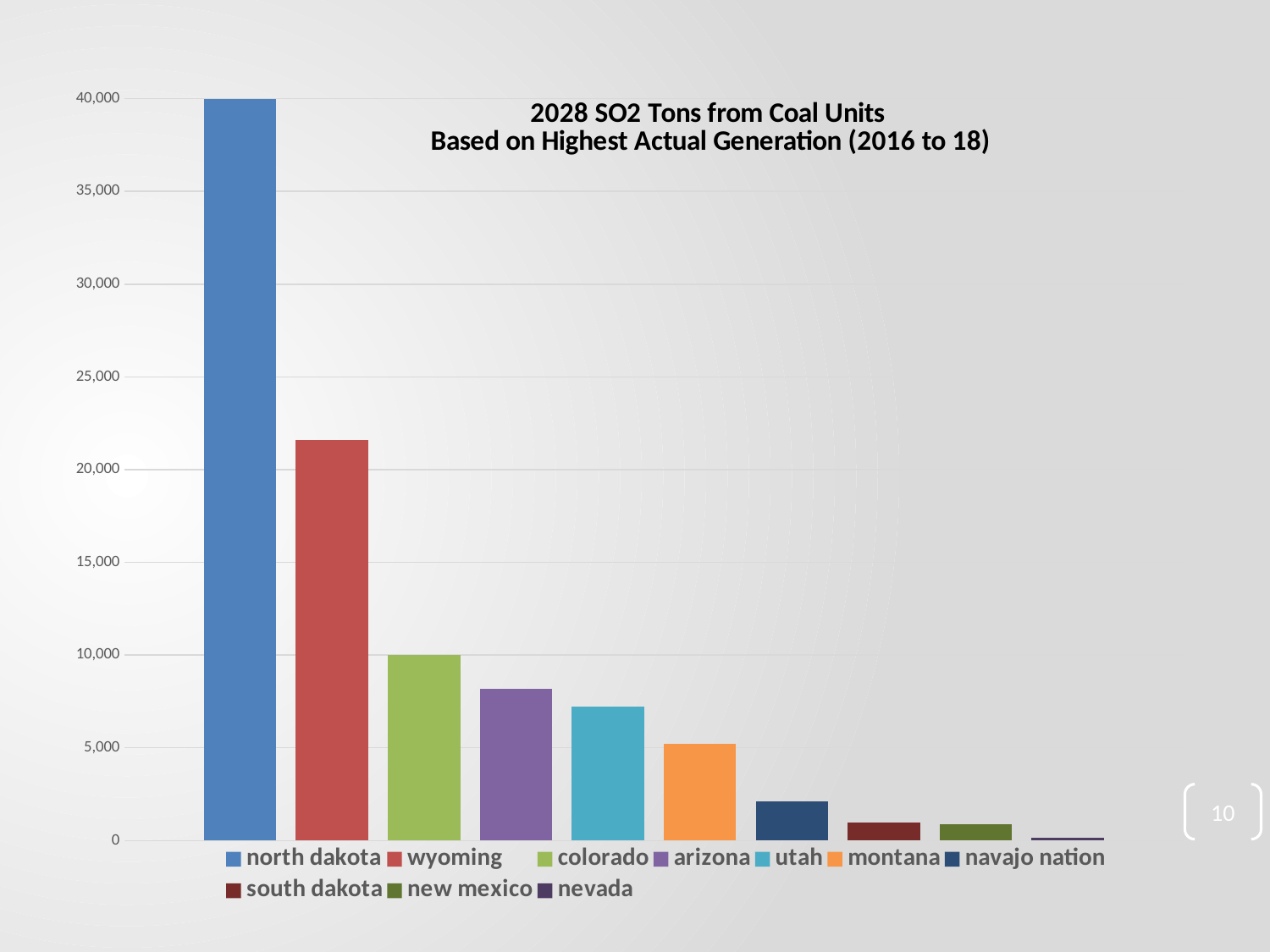
Is the value for arizona greater or less than 10,000? less How many categories are plotted in the chart? 10 Which is larger, the value for wyoming or the value for colorado? wyoming Is the value for navajo nation greater or less than 5,000? less Which is larger, the value for arizona or the value for utah? arizona Do the values rise or fall moving from left to right across the chart? fall How many entries does the legend list? 10 What is the title of the chart? 2028 SO2 Tons from Coal Units Based on Highest Actual Generation (2016 to 18) What kind of chart is shown on the slide? bar chart Which category has the highest value? north dakota Is the value for wyoming greater or less than 20,000? greater Which category has the lowest value? nevada